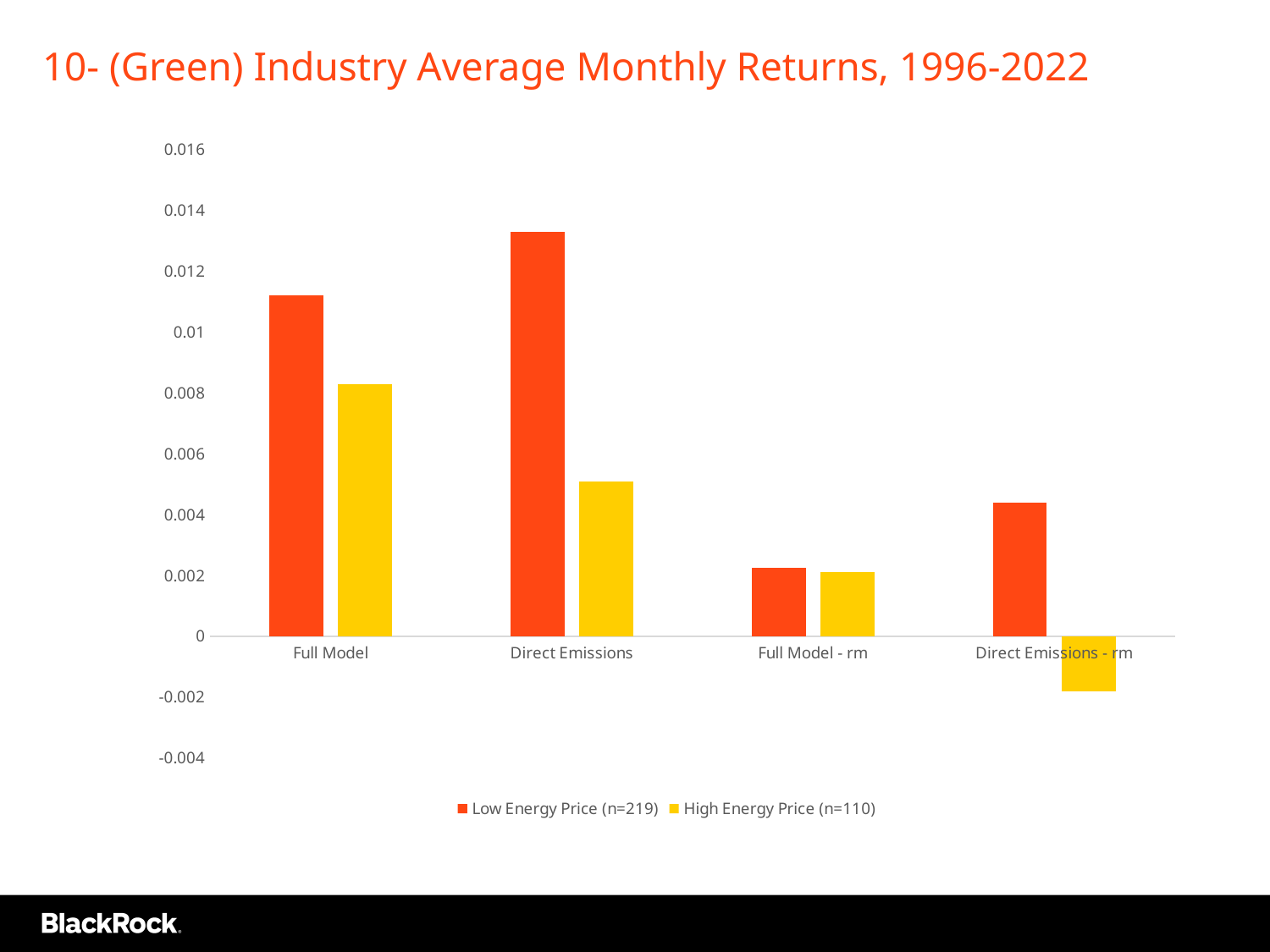
Is the High Energy Price (n=110) value for Direct Emissions - rm greater or less than 0? less For the Low Energy Price (n=219) series, which is larger: Full Model or Direct Emissions? Direct Emissions Which category has the highest High Energy Price (n=110) value? Full Model Which category has the lowest High Energy Price (n=110) value? Direct Emissions - rm Which category has the highest Low Energy Price (n=219) value? Direct Emissions How many series does the legend list? 2 Is the Low Energy Price (n=219) value for Direct Emissions greater or less than 0.012? greater Is the High Energy Price (n=110) value for Full Model greater or less than 0.01? less How many categories are shown on the x axis of the chart? 4 What is the title of the chart? 10- (Green) Industry Average Monthly Returns, 1996-2022 For Full Model, which series has the larger value: Low Energy Price (n=219) or High Energy Price (n=110)? Low Energy Price (n=219) What kind of chart is shown on the slide? bar chart